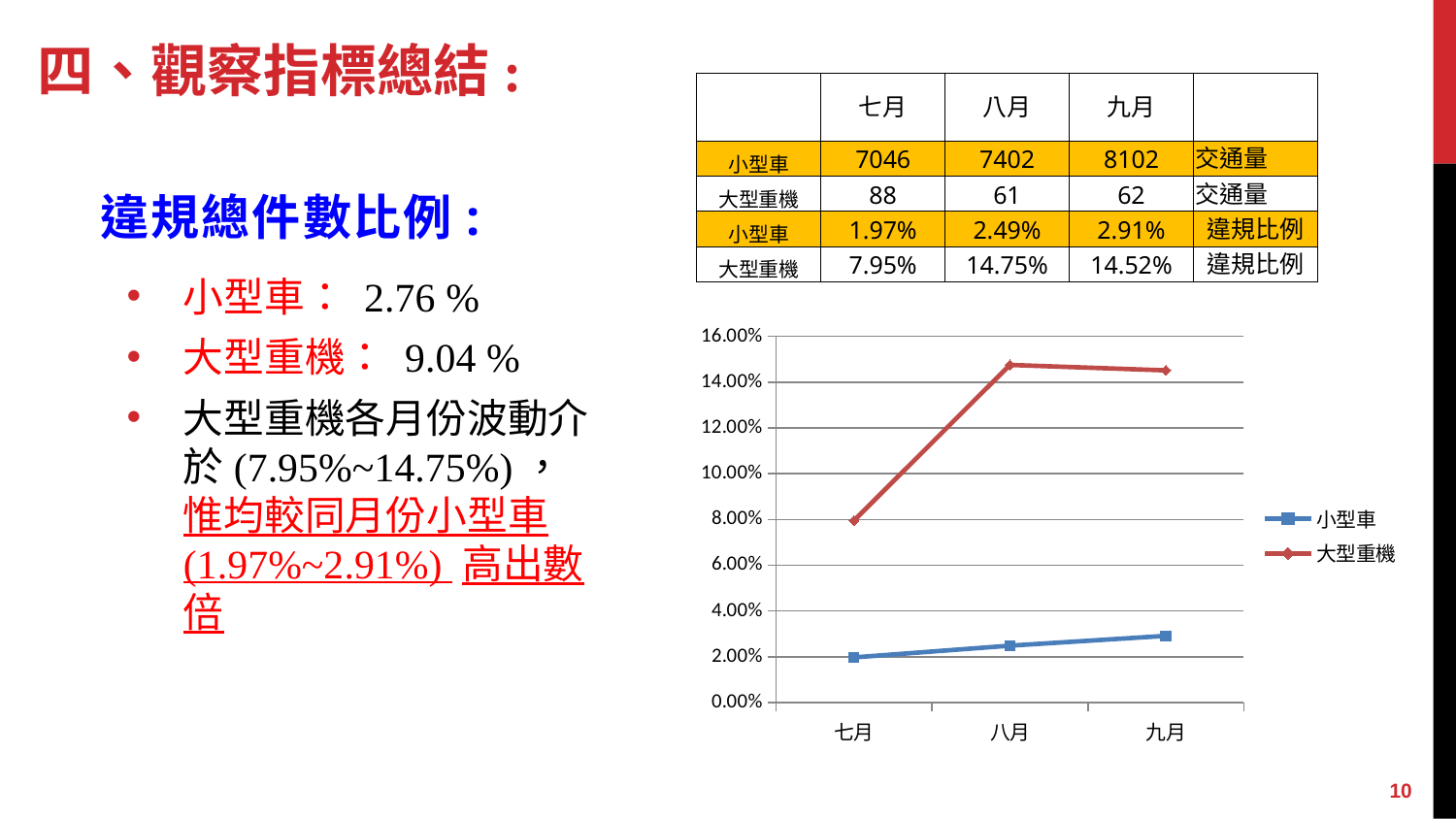
Is the value for 大型重機 in 七月 greater or less than 6.00%? greater Is the value for 小型車 in 七月 greater or less than 4.00%? less In 八月, which series has the larger value, 小型車 or 大型重機? 大型重機 In which month is the value for 小型車 highest? 九月 What kind of chart is shown on the slide? line chart Which colour is the 大型重機 line in the chart? red Do the values for 小型車 rise or fall from 七月 to 九月? rise According to the table on the slide, what is the 違規比例 for 大型重機 in 八月? 14.75% How many series does the chart legend list? 2 How many months are plotted along the x axis of the chart? 3 Is the value for 大型重機 in 八月 greater or less than 14.00%? greater In which month is the value for 小型車 lowest? 七月